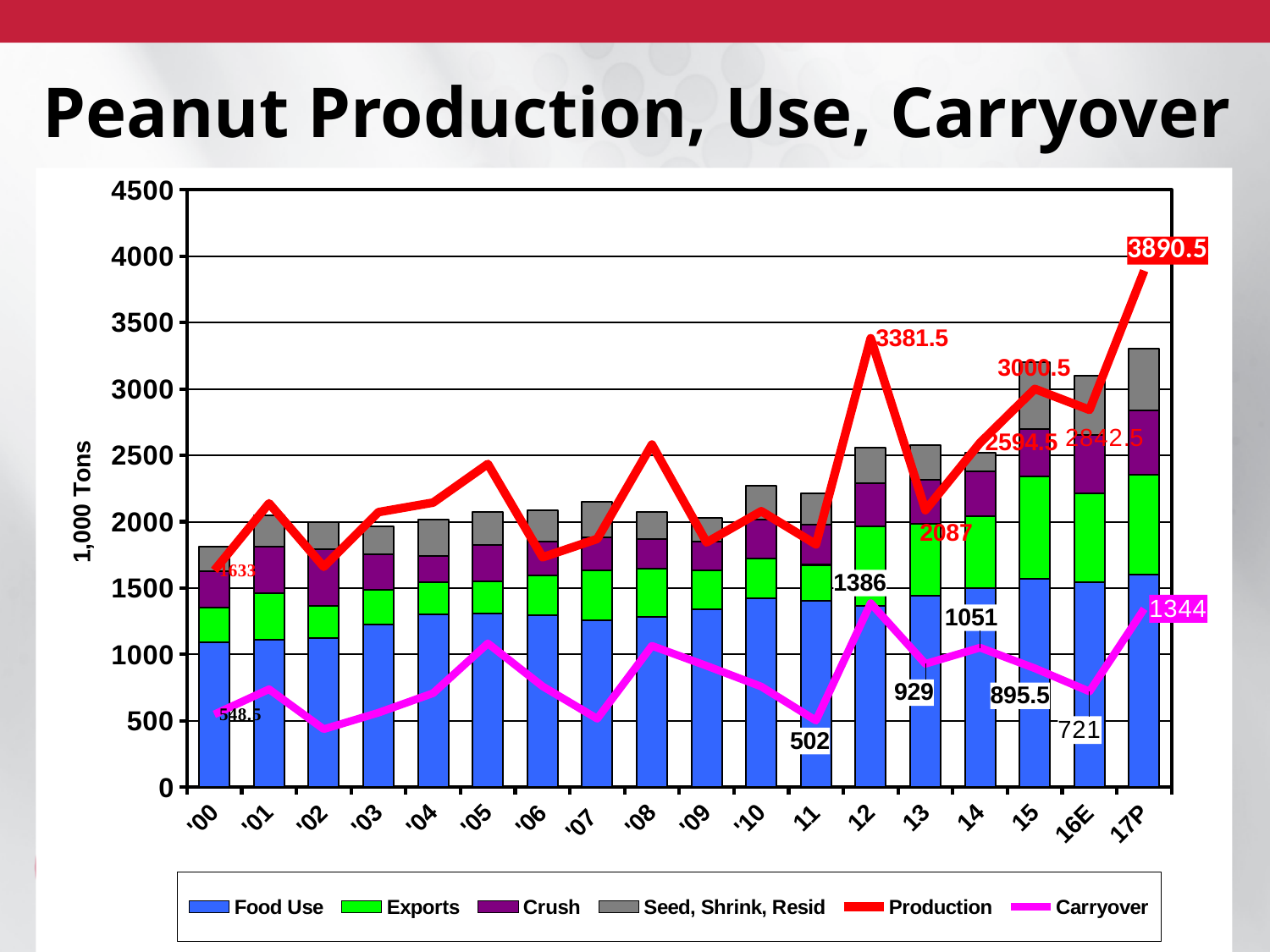
What is the Carryover value for '11? 502 What is the Production value for '13? 2087 Is the Production value for '08 greater or less than 2500? greater Which is larger, the Carryover value for '12 or for '14? '12 Which year has the highest Production value? '17P What is the difference between the Production values for '17P and '12? 509 How many series does the legend list? 6 What is the Production value for '12? 3381.5 What is the Carryover value for '17P? 1344 What is the Production value for '17P? 3890.5 What is the Carryover value for '16E? 721 How many years are shown on the x axis? 18